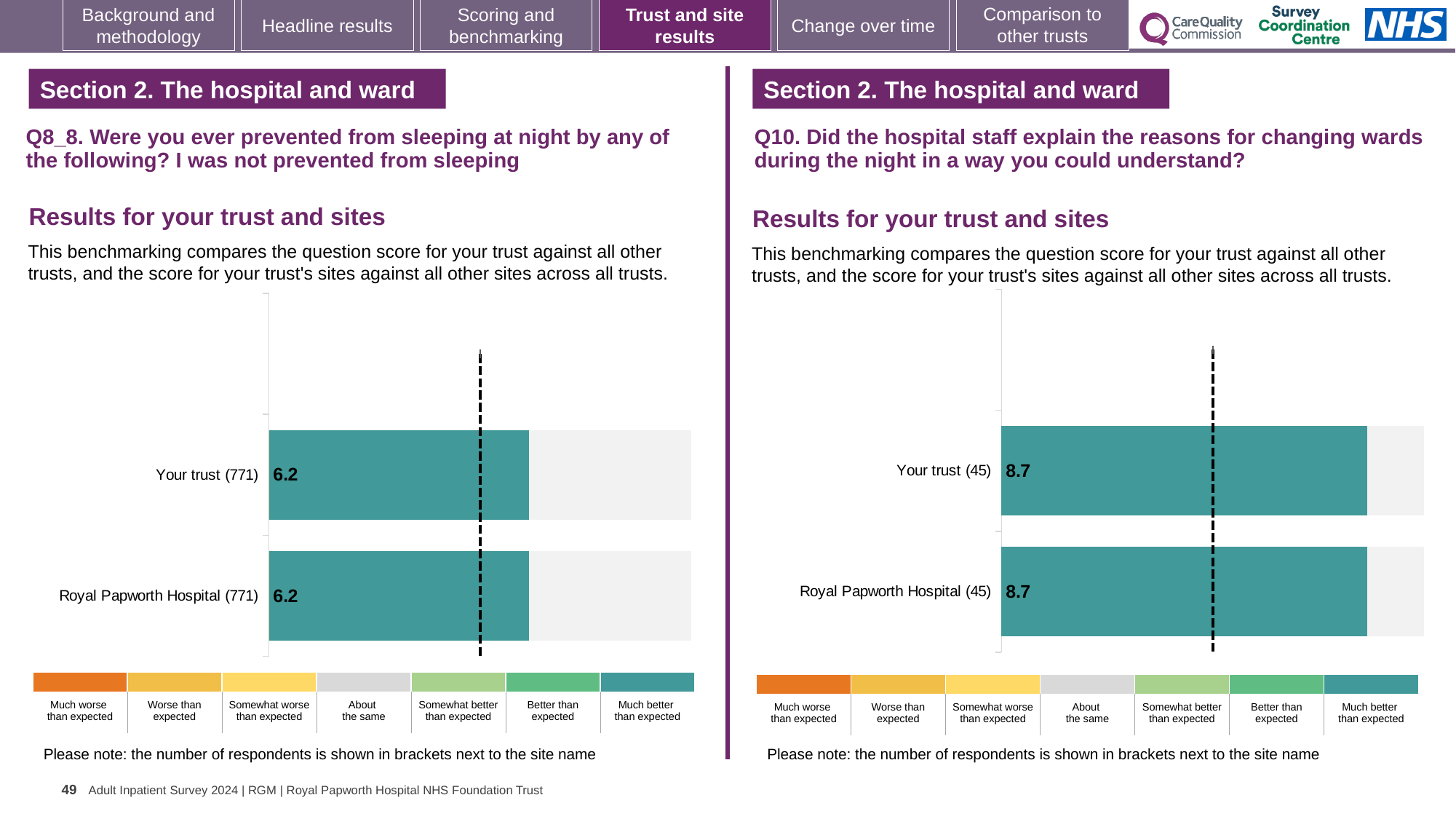
On the left chart (Q8_8), how many respondents are shown in brackets for Your trust? 771 On the right chart (Q10), what is the score for Royal Papworth Hospital? 8.7 On the left chart (Q8_8), what is the difference between the score for Your trust and the score for Royal Papworth Hospital? 0 How many bars are plotted on the right chart (Q10)? 2 Is the score for Your trust on the right chart (Q10) larger or smaller than the score for Your trust on the left chart (Q8_8)? Larger On the left chart (Q8_8), what is the score for Royal Papworth Hospital? 6.2 On the left chart (Q8_8), what is the score for Your trust? 6.2 On the right chart (Q10), what is the difference between the score for Your trust and the score for Royal Papworth Hospital? 0 On the right chart (Q10), how many respondents are shown in brackets for Royal Papworth Hospital? 45 How many bars are plotted on the left chart (Q8_8)? 2 What kind of chart is used on the left (Q8_8)? Bar chart On the right chart (Q10), what is the score for Your trust? 8.7